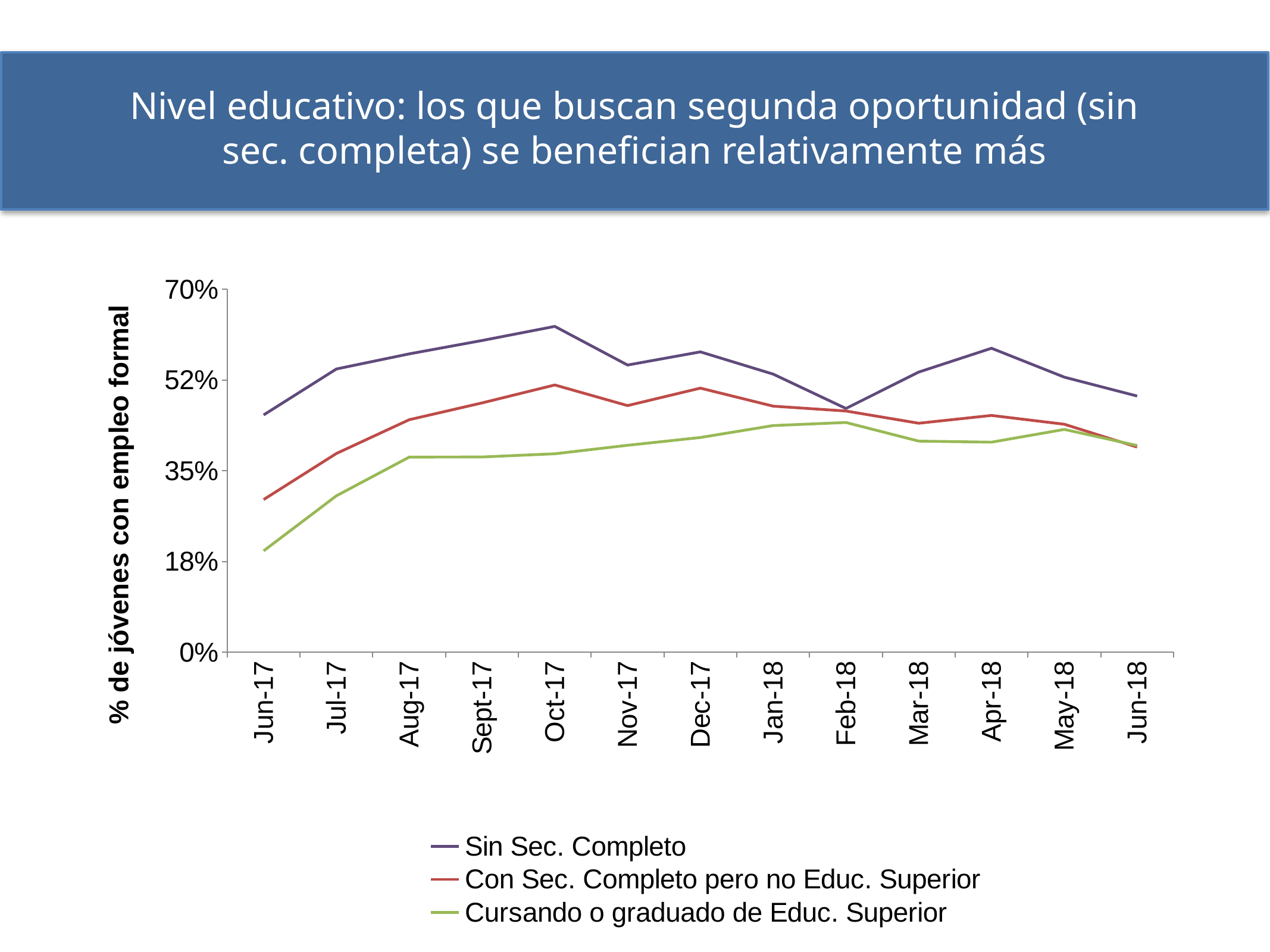
Is the value for Con Sec. Completo pero no Educ. Superior in Jun-17 greater or less than 35%? less What is the title of the y axis? % de jóvenes con empleo formal Does the Cursando o graduado de Educ. Superior line rise or fall from Jun-17 to Aug-17? rise How many series does the legend list? 3 In which month does the Sin Sec. Completo line reach its highest value? Oct-17 In which month is the Cursando o graduado de Educ. Superior line at its lowest? Jun-17 In Jun-17, which series has the larger value: Sin Sec. Completo or Cursando o graduado de Educ. Superior? Sin Sec. Completo Is the value for Cursando o graduado de Educ. Superior in Jun-17 greater or less than 18%? greater Is the value for Sin Sec. Completo in Oct-17 greater or less than 52%? greater In which month is the Con Sec. Completo pero no Educ. Superior line at its lowest? Jun-17 How many months are plotted along the x axis? 13 What kind of chart is shown on the slide? line chart